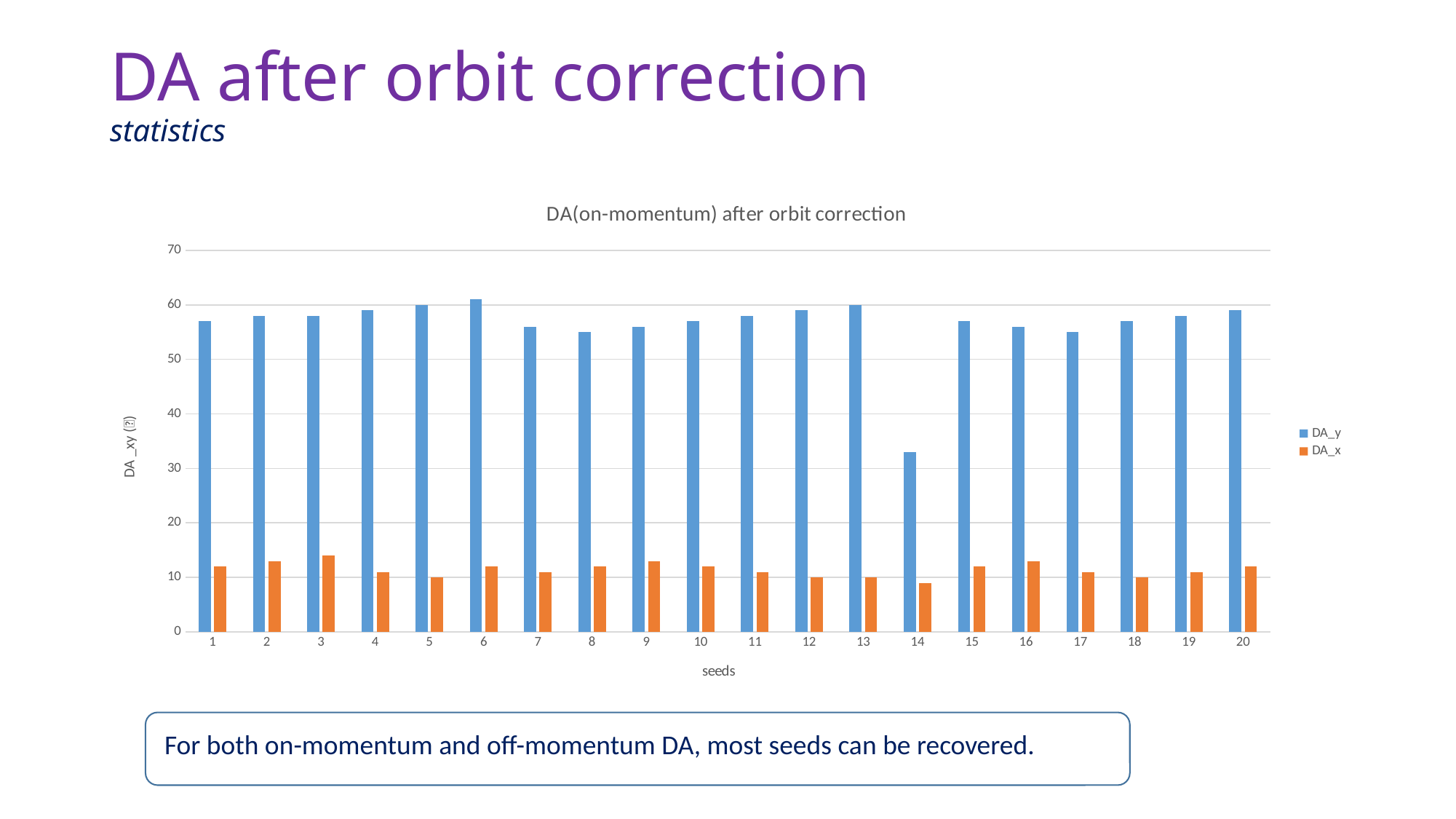
How many seeds are shown along the x axis? 20 Is the DA_y value for seed 14 greater or less than 40? less Is the DA_x value for seed 2 greater or less than 20? less Which seed has the larger DA_y value, seed 13 or seed 14? 13 How many series does the legend list? 2 Which seed has the lowest DA_y value? 14 Is the DA_x value for seed 3 greater or less than 10? greater What kind of chart is shown on the slide? bar chart What is the label of the x axis? seeds What is the title of the chart? DA(on-momentum) after orbit correction Which is larger for seed 14: the DA_y value or the DA_x value? DA_y